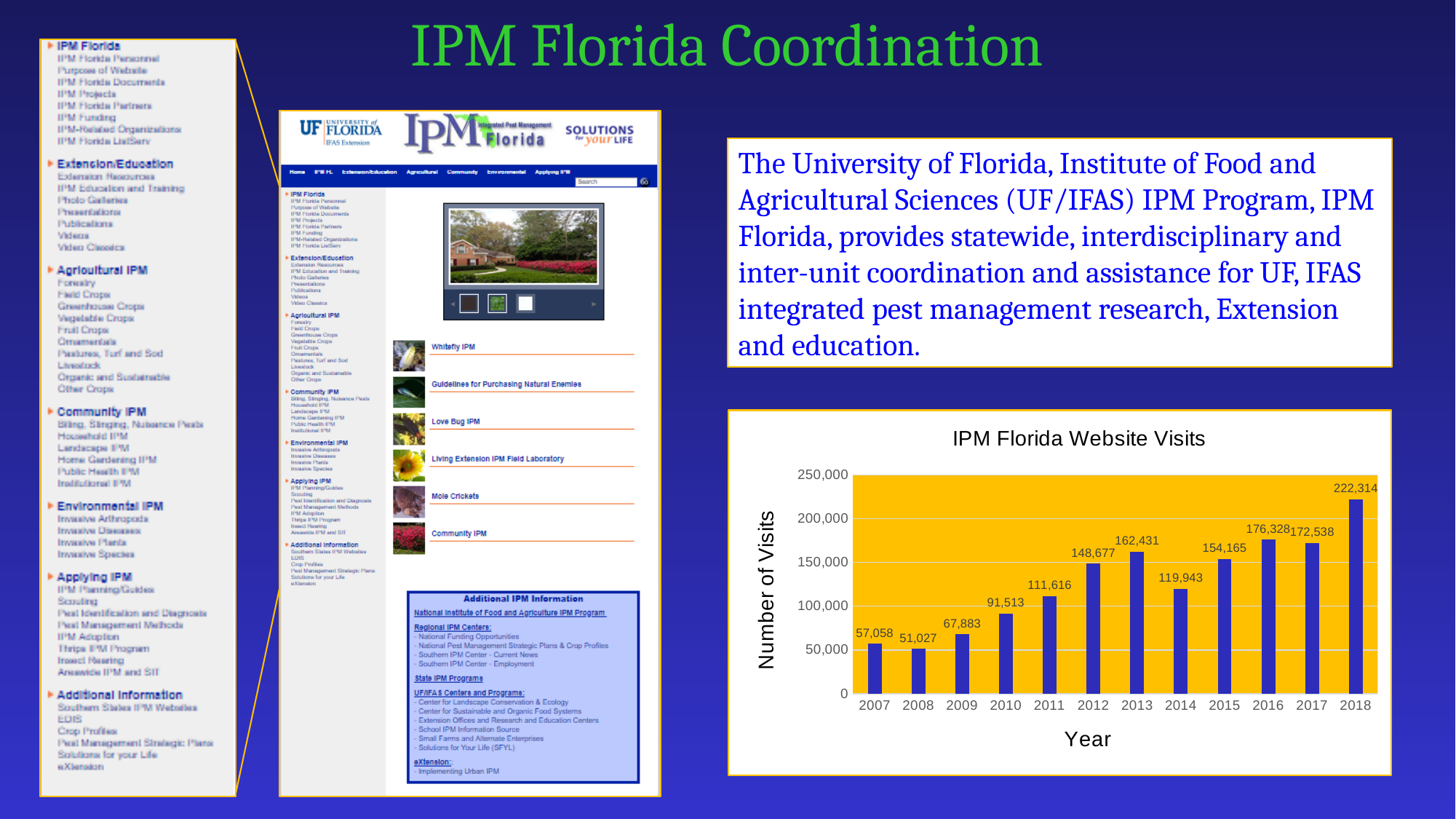
What kind of chart is used to show IPM Florida Website Visits? bar chart What is the label on the y axis of the chart? Number of Visits What is the number of visits shown for 2018? 222,314 What is the title of the chart on the slide? IPM Florida Website Visits Which year had more visits, 2013 or 2014? 2013 What is the difference in visits between 2018 and 2017? 49,776 How many visits did the IPM Florida website receive in 2012? 148,677 Which year has the highest number of website visits? 2018 Is the value for 2011 greater or less than 100,000? greater How many years are shown on the x axis of the chart? 12 Which year has the lowest number of website visits? 2008 What is the difference in visits between 2014 and 2013? 42,488